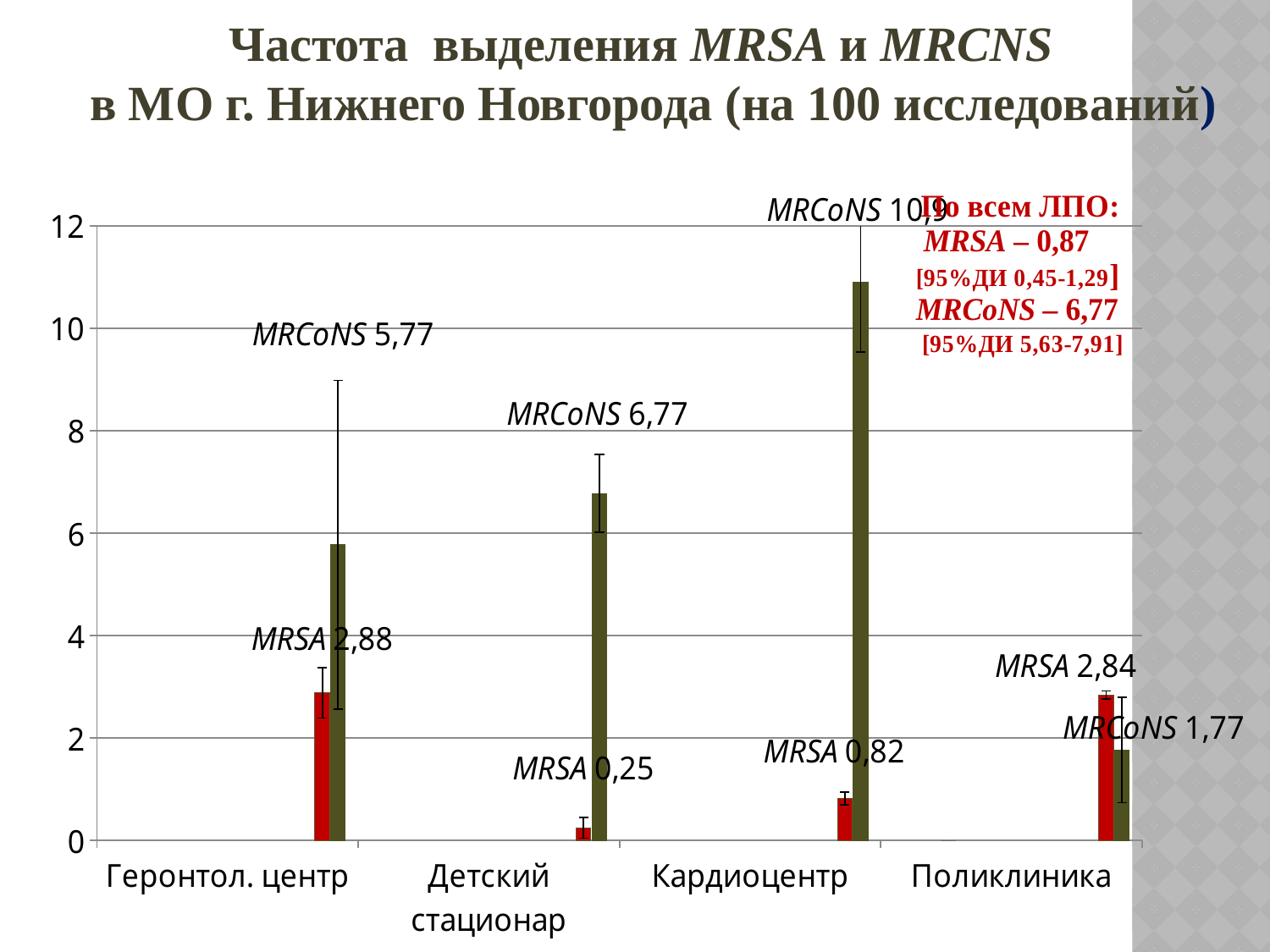
What is the MRSA value for Кардиоцентр? 0,82 What is the MRCoNS value for Поликлиника? 1,77 Which medical organisation has the highest MRCoNS value? Кардиоцентр What is the MRSA value for Геронтол. центр? 2,88 Is the MRCoNS value for Кардиоцентр greater or less than 10? greater What type of chart is shown on the slide? bar chart Which medical organisation has the lowest MRSA value? Детский стационар What is the MRCoNS value for Геронтол. центр? 5,77 What is the MRCoNS value for Детский стационар? 6,77 What is the MRSA value for Детский стационар? 0,25 For Поликлиника, which is larger: the MRSA value or the MRCoNS value? MRSA How many medical organisations (categories) are shown on the x axis? 4